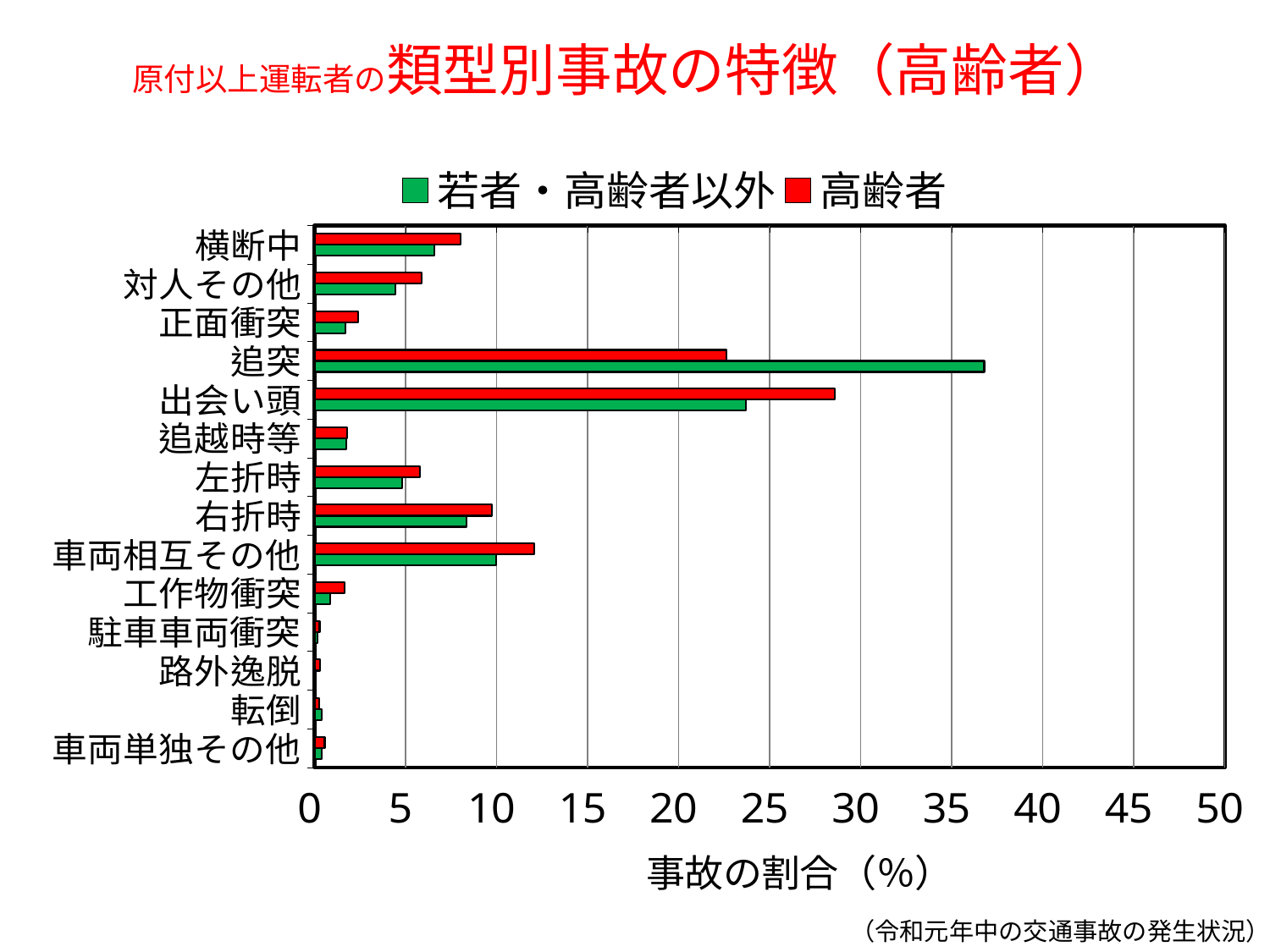
For 出会い頭, which series has the larger value, 若者・高齢者以外 or 高齢者? 高齢者 Is the value for 出会い頭 in the 高齢者 series greater or less than 25? greater What kind of chart is shown on the slide? bar chart How many accident categories are shown on the vertical axis? 14 For 追突, which series has the larger value, 若者・高齢者以外 or 高齢者? 若者・高齢者以外 What is the label of the horizontal axis? 事故の割合（%） Is the value for 追突 in the 若者・高齢者以外 series greater or less than 35? greater How many series does the legend list? 2 Which category has the highest value for 高齢者? 出会い頭 Is the value for 追突 in the 高齢者 series greater or less than 25? less Which category has the highest value for 若者・高齢者以外? 追突